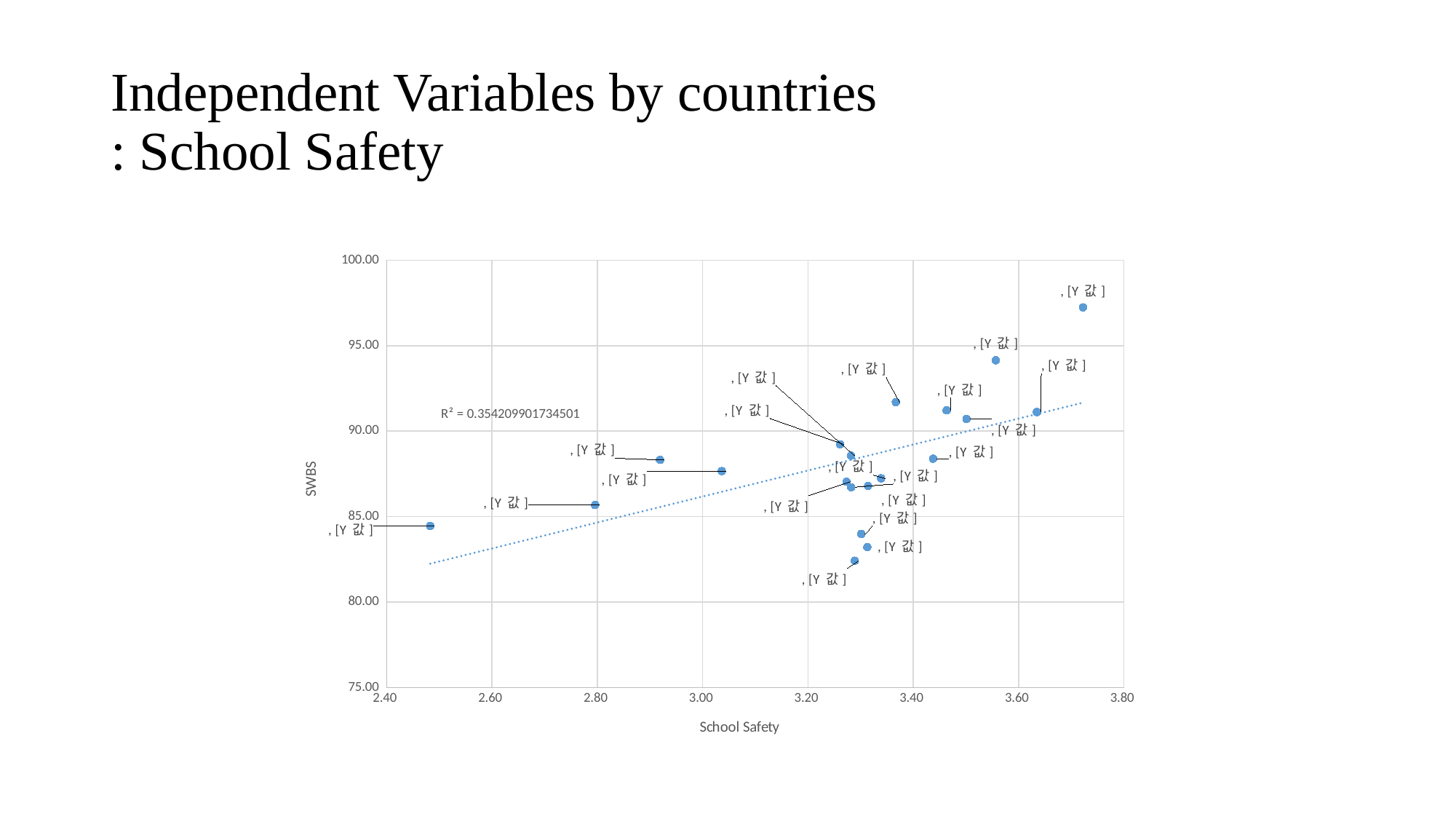
What is the minimum value shown on the x axis of the chart? 2.40 What R² value is printed on the chart? R² = 0.354209901734501 What is the title of the x axis of the chart? School Safety Which point has the higher SWBS value: the rightmost point or the leftmost point? the rightmost point Does the dotted trend line rise or fall as School Safety increases? rises Is the SWBS value of the highest point on the chart greater or less than 95.00? greater What is the title of the y axis of the chart? SWBS Is the SWBS value of the lowest point on the chart greater or less than 80.00? greater Is the School Safety value of the leftmost point greater or less than 2.60? less What is the maximum value shown on the y axis of the chart? 100.00 What kind of chart is shown on the slide? scatter plot